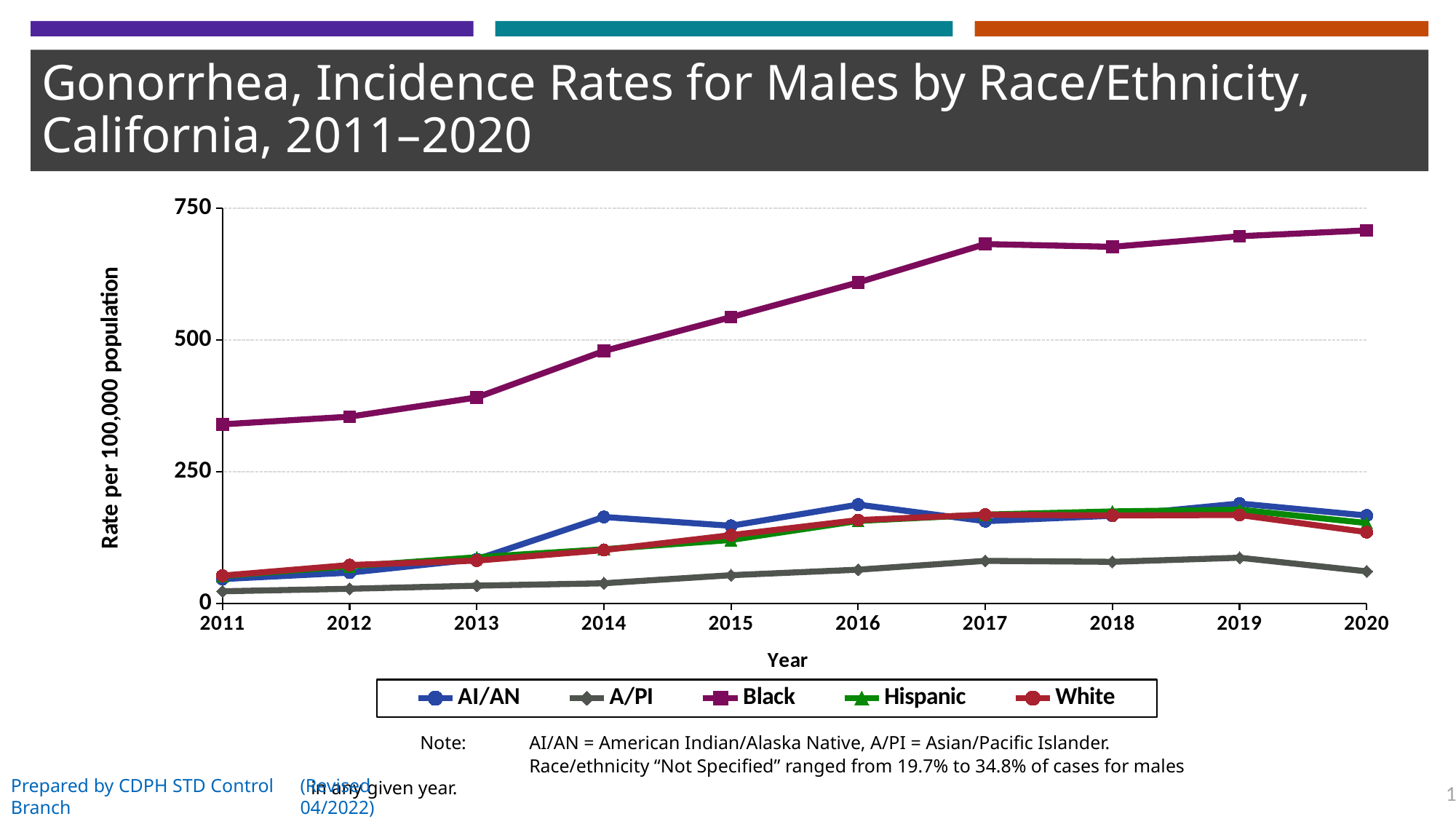
Is the rate for Black males in 2016 greater or less than 500? greater Does the rate for Black males generally rise or fall from 2011 to 2019? rise Is the rate for A/PI males in 2019 greater or less than 250? less Which race/ethnicity group has the lowest gonorrhea incidence rate in 2020? A/PI Is the rate for Black males in 2020 greater or less than 500? greater How many series does the legend list? 5 Which is larger in 2016, the rate for Black males or the rate for A/PI males? Black How many years are plotted along the x axis? 10 Which race/ethnicity group has the highest gonorrhea incidence rate in 2020? Black What kind of chart is shown on the slide? line chart What is the label on the y axis of the chart? Rate per 100,000 population